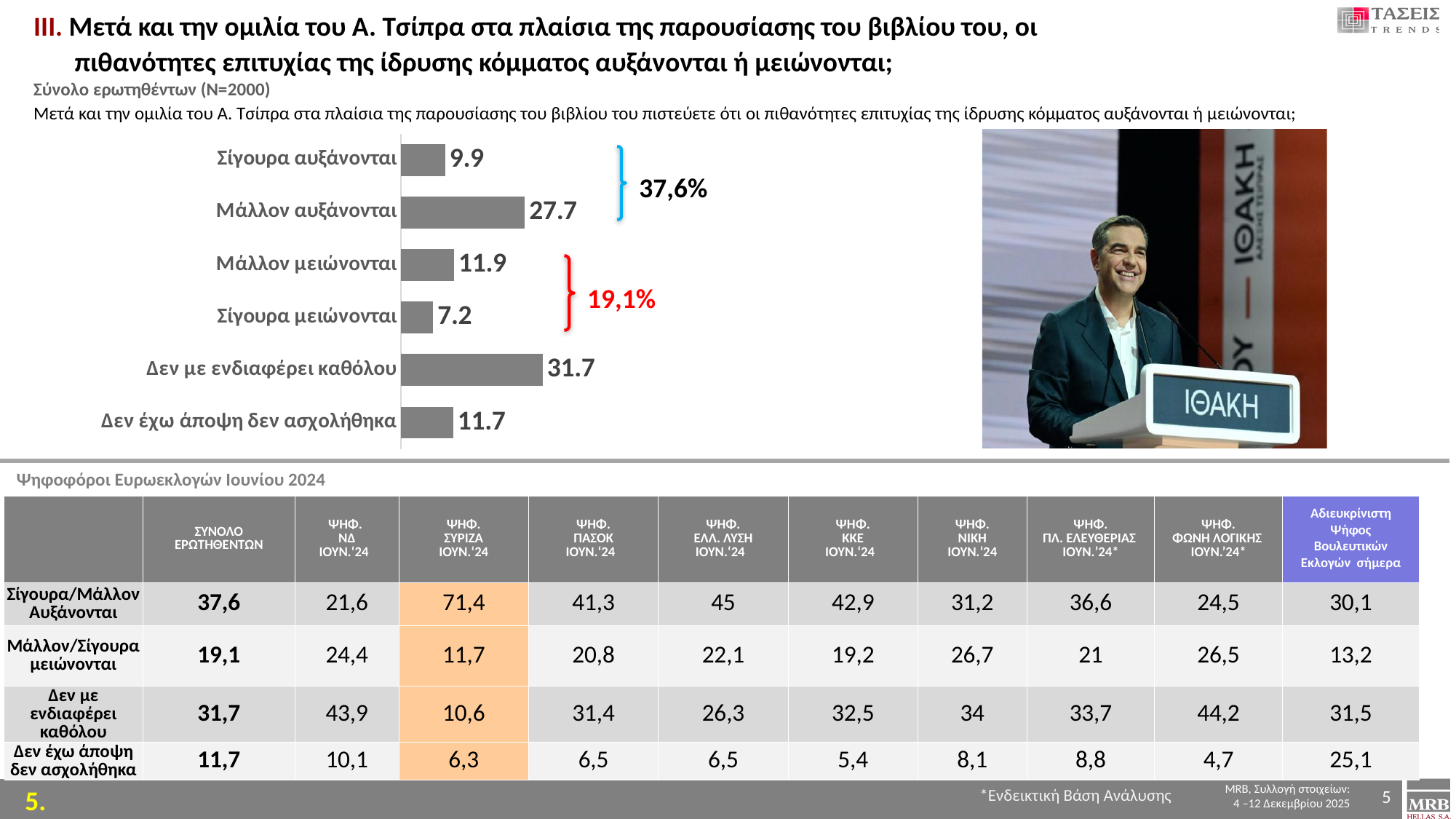
What is the value for 'Μάλλον αυξάνονται' in the bar chart? 27.7 What combined percentage does the red bracket next to the two 'μειώνονται' bars show? 19,1% What is the value for 'Δεν έχω άποψη δεν ασχολήθηκα' in the bar chart? 11.7 Which category has the lowest value in the bar chart? Σίγουρα μειώνονται What is the value for 'Δεν με ενδιαφέρει καθόλου' in the bar chart? 31.7 Which is larger in the bar chart: 'Μάλλον αυξάνονται' or 'Μάλλον μειώνονται'? Μάλλον αυξάνονται What is the value for 'Σίγουρα αυξάνονται' in the bar chart? 9.9 Which category has the highest value in the bar chart? Δεν με ενδιαφέρει καθόλου How many categories does the bar chart show? 6 What is the difference between the values for 'Μάλλον αυξάνονται' and 'Σίγουρα αυξάνονται'? 17.8 What type of chart is shown on the slide? bar chart What combined percentage does the blue bracket next to the two 'αυξάνονται' bars show? 37,6%